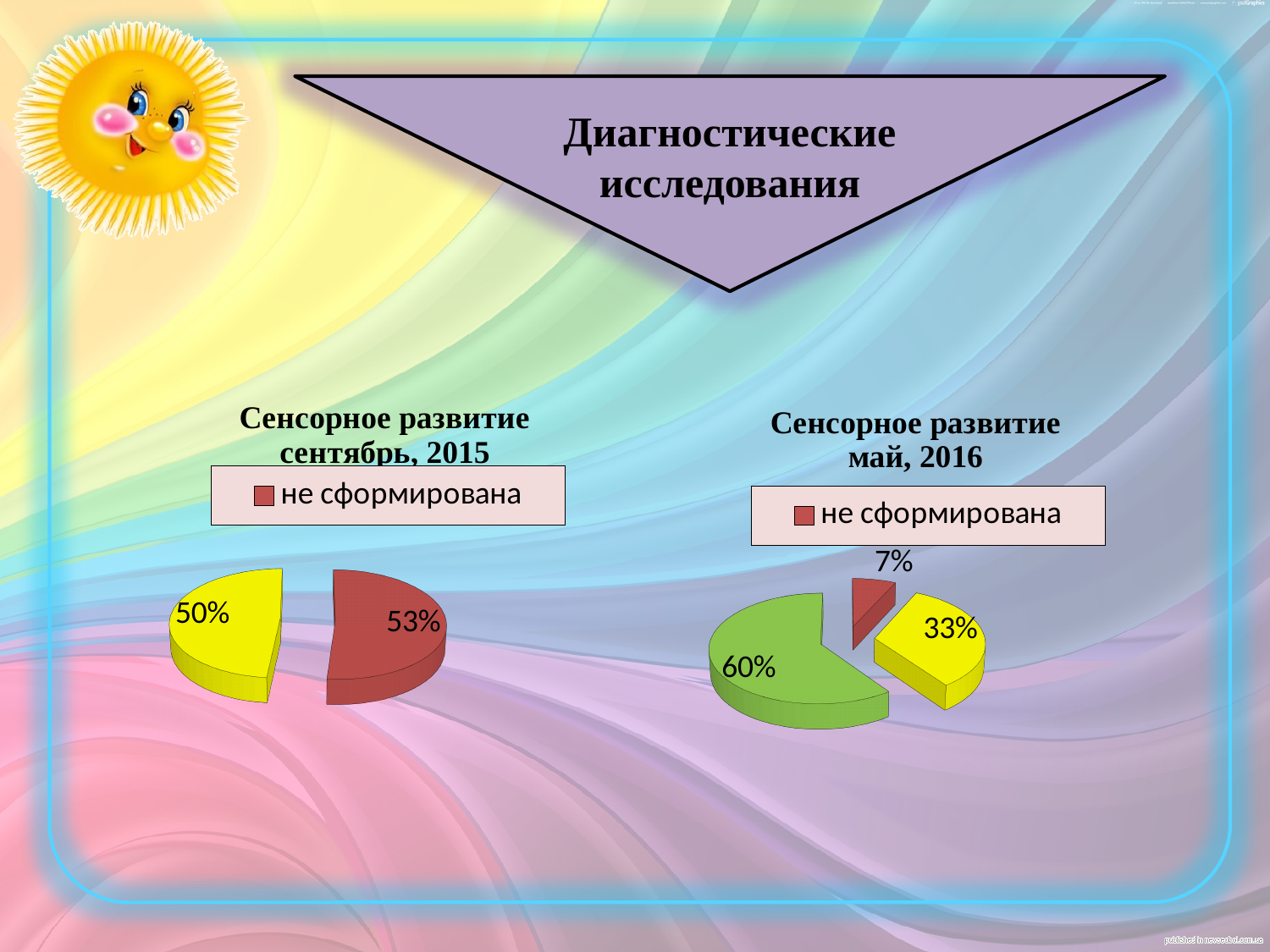
In the chart "Сенсорное развитие май, 2016", what is the difference between the green slice (60%) and the yellow slice (33%)? 27% Which chart has the larger "не сформирована" slice, "Сенсорное развитие сентябрь, 2015" or "Сенсорное развитие май, 2016"? Сенсорное развитие сентябрь, 2015 In the chart "Сенсорное развитие май, 2016", what is the value of the smallest slice? 7% How many slices does the chart "Сенсорное развитие сентябрь, 2015" have? 2 What kind of chart is shown under the title "Сенсорное развитие сентябрь, 2015"? pie chart What kind of chart is shown under the title "Сенсорное развитие май, 2016"? pie chart How many slices does the chart "Сенсорное развитие май, 2016" have? 3 In the chart "Сенсорное развитие сентябрь, 2015", what is the value of the "не сформирована" slice? 53% What is the difference between the "не сформирована" values in the September 2015 chart and the May 2016 chart? 46% What legend entry is shown for the chart "Сенсорное развитие май, 2016"? не сформирована In the chart "Сенсорное развитие май, 2016", what is the value of the largest slice? 60% In the chart "Сенсорное развитие май, 2016", what is the value of the "не сформирована" slice? 7%